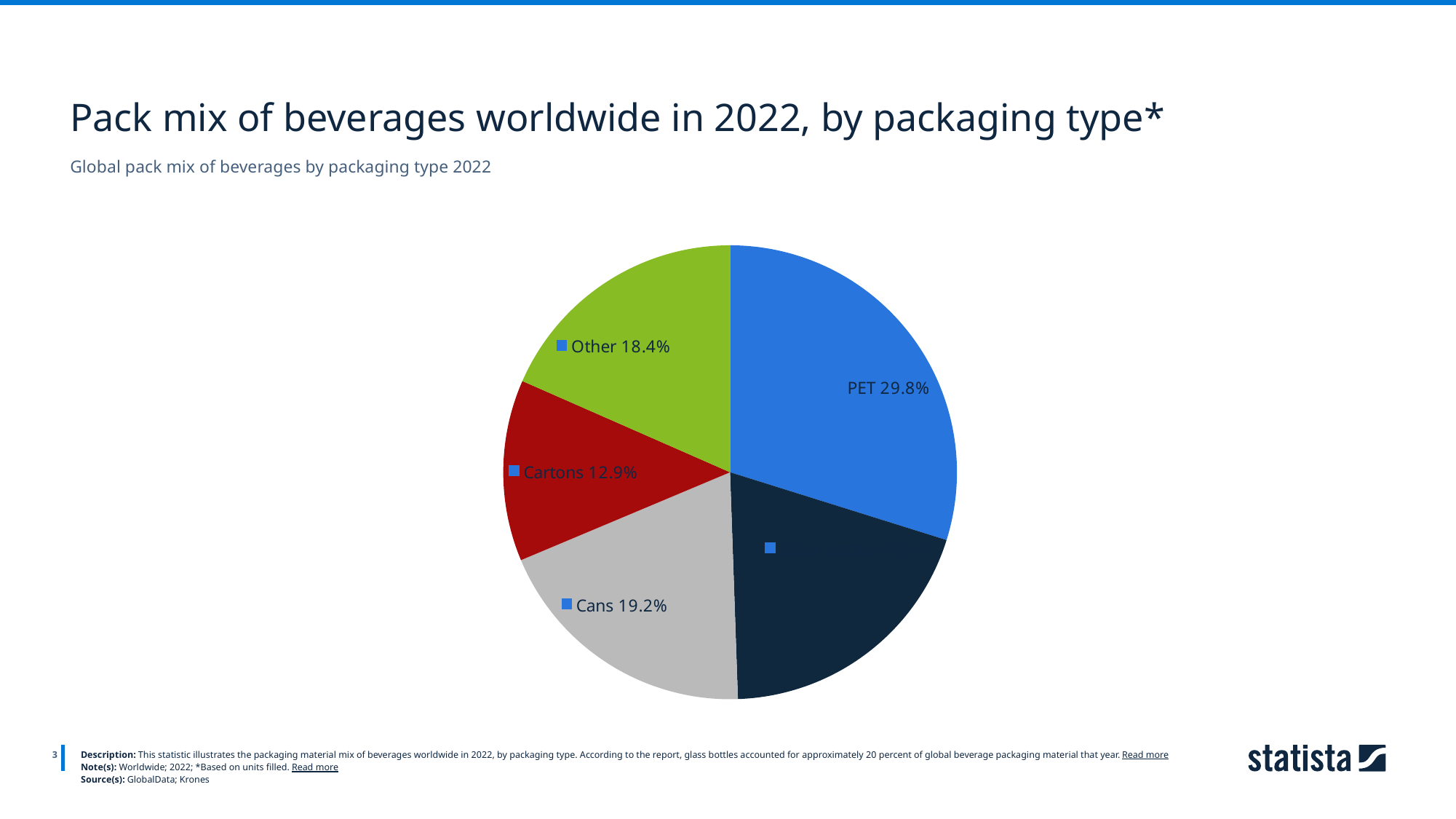
What is the difference in percentage points between Other and Cartons? 5.5 Which packaging type has the largest slice of the pie? PET What share of the pie does PET account for? 29.8% How many slices does the pie chart have? 5 Which labelled packaging type has the smallest slice? Cartons What share is shown for the Other category? 18.4% Which is larger, the share for Cans or the share for Other? Cans What is the value labelled for Cartons? 12.9% What is the title of the chart on the slide? Pack mix of beverages worldwide in 2022, by packaging type* What kind of chart is shown on the slide? Pie chart What is the difference in percentage points between PET and Cartons? 16.9 What percentage is shown for Cans? 19.2%